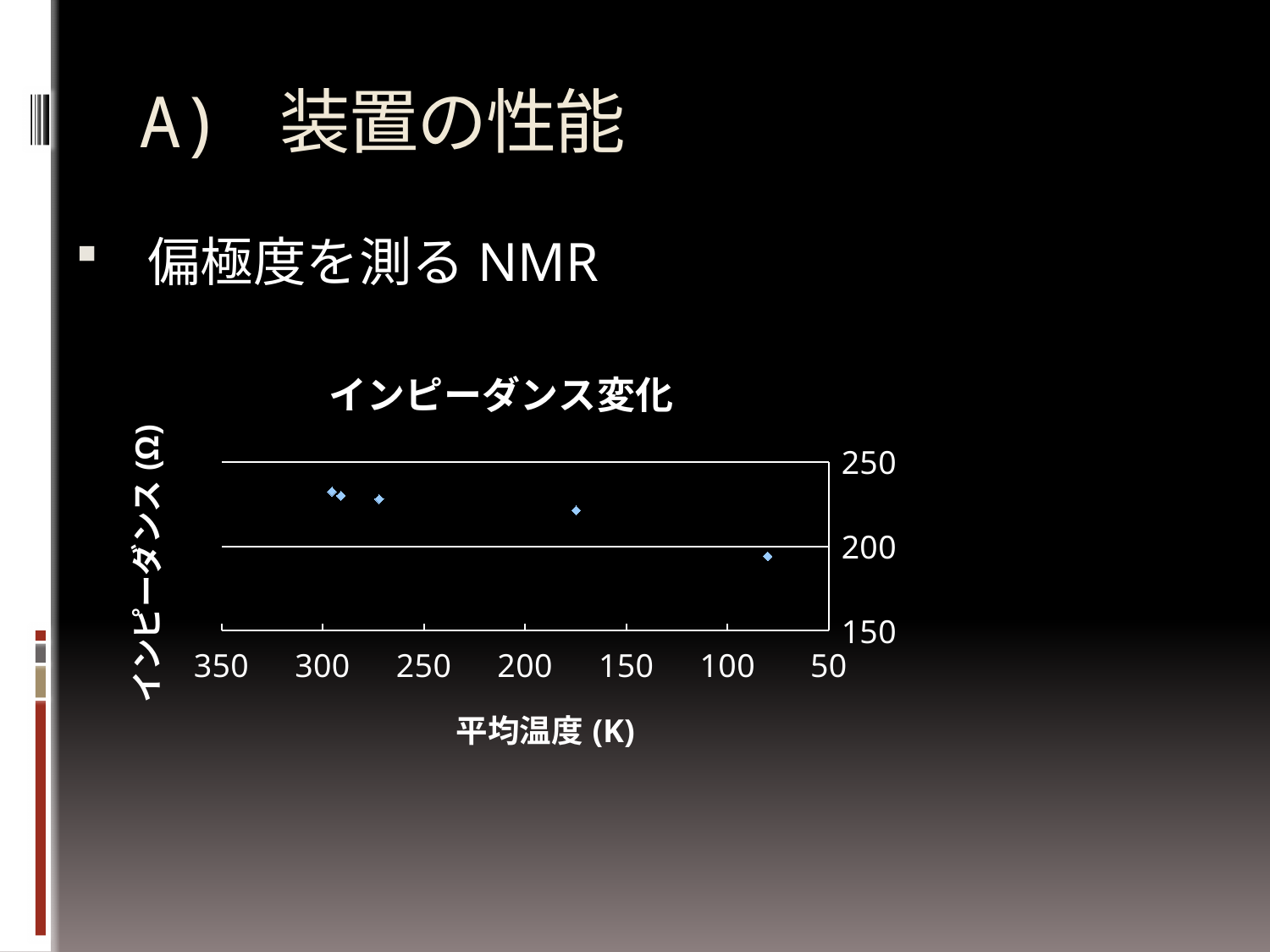
Is the impedance value of the point at the lowest temperature (near 80 K) greater or less than 200? less What is the highest value shown on the y axis of the chart? 250 Which point has the lowest impedance: the one near 80 K or the one near 175 K? the one near 80 K What is the title of the chart? インピーダンス変化 Is the impedance value of the point near 175 K greater or less than 200? greater Is the impedance value of the point near 270 K greater or less than 200? greater What kind of chart is shown on the slide? scatter chart How many data points are plotted in the chart? 5 What is the label of the x axis of the chart? 平均温度 (K) Do the impedance values rise or fall moving from left to right along the x axis? fall Which point has the larger impedance: the one near 270 K or the one near 80 K? the one near 270 K